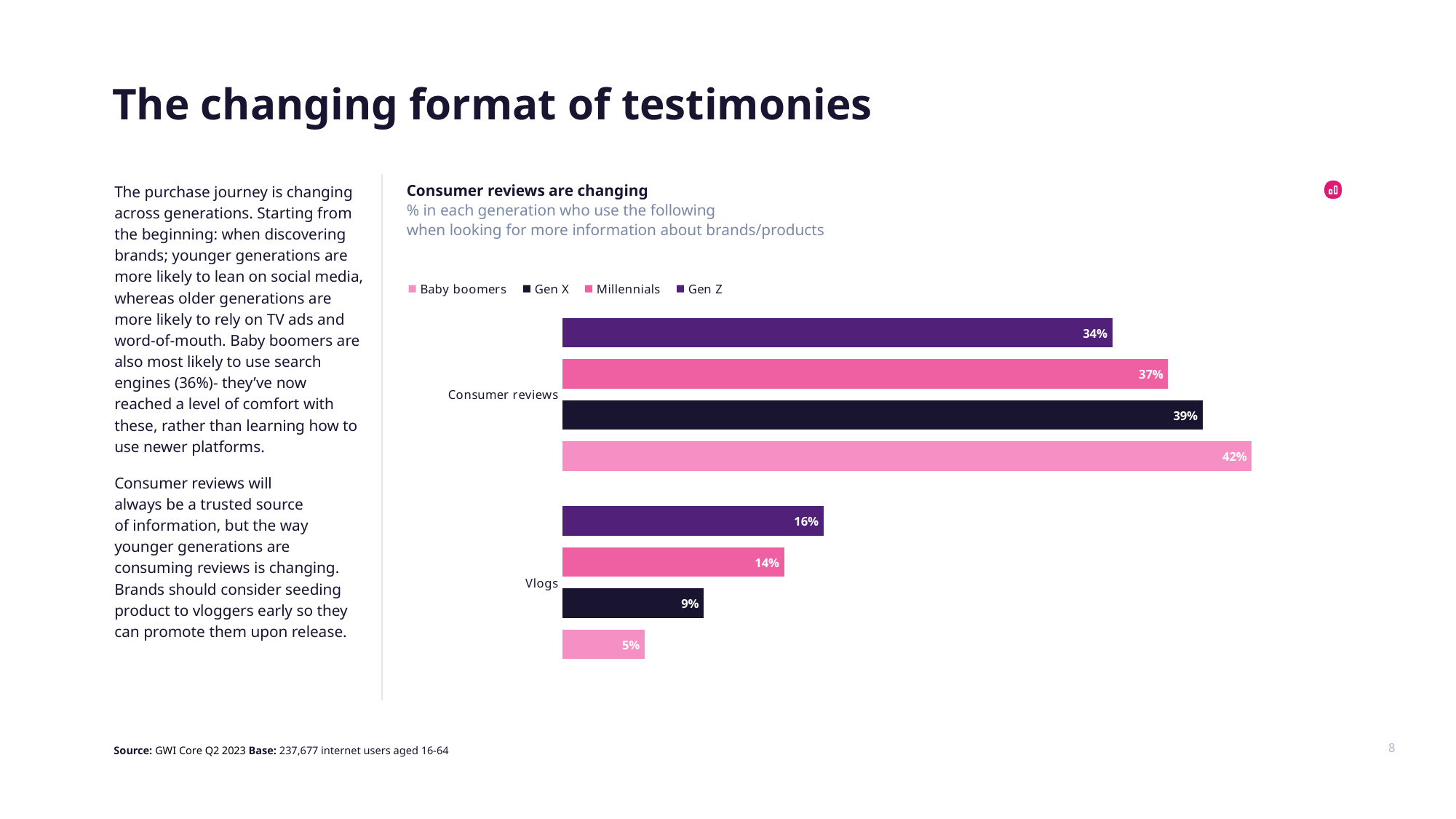
What percentage of Baby boomers use consumer reviews when looking for more information about brands/products? 42% Which generation has the highest value for Consumer reviews? Baby boomers What is the value for Gen X in the Consumer reviews category? 39% Which generation has the lowest value for Vlogs? Baby boomers What percentage of Gen Z use vlogs when looking for more information about brands/products? 16% What kind of chart is shown on the slide? Bar chart Which is larger: the Millennials value for Vlogs or the Gen X value for Vlogs? Millennials What is the title of the chart? Consumer reviews are changing What is the difference between the Baby boomers and Gen Z values for Consumer reviews? 8% What is the value for Millennials in the Vlogs category? 14% How many series does the legend list? 4 What is the difference between the Gen Z and Gen X values for Vlogs? 7%